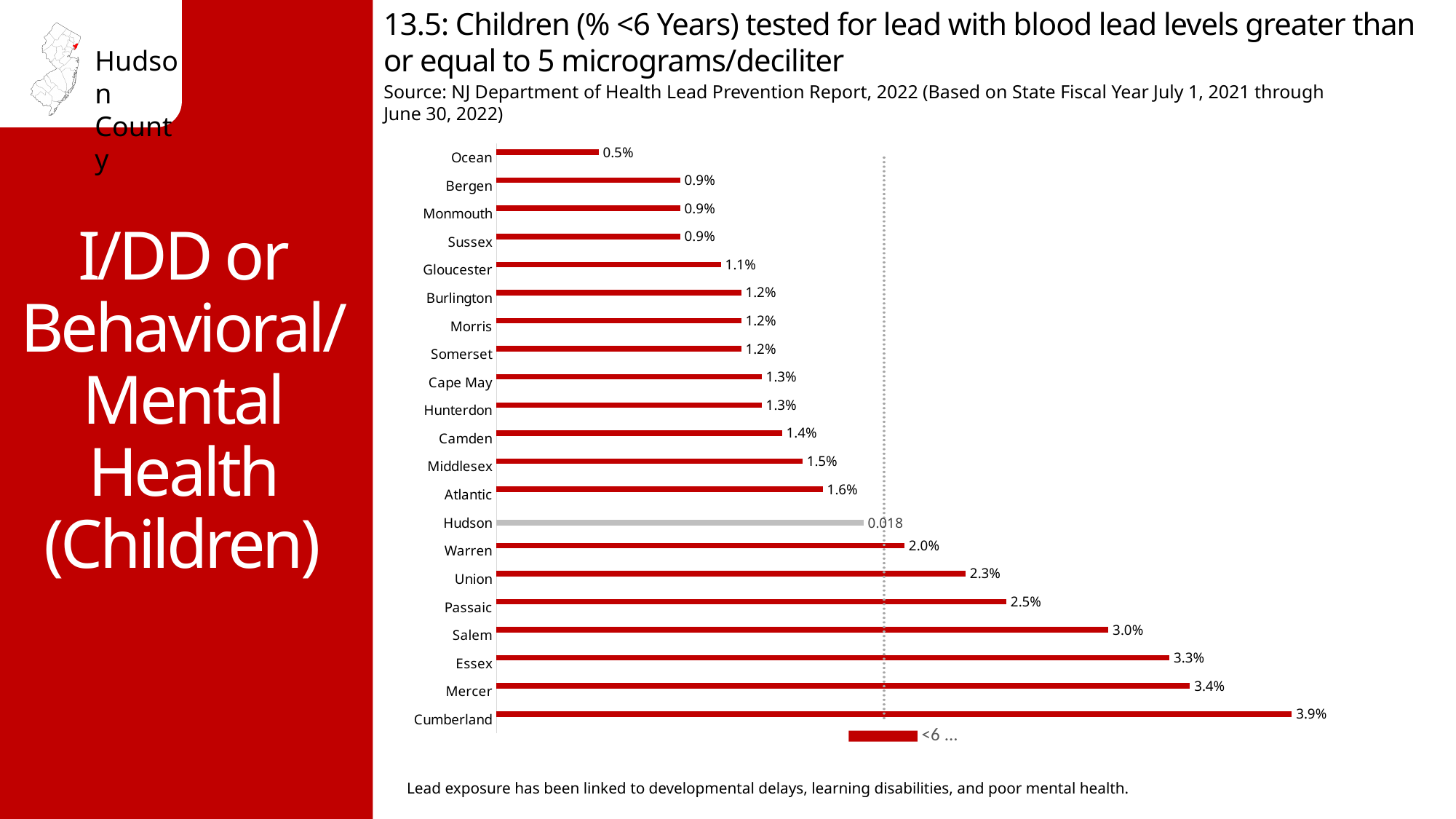
What value is printed next to the Hudson bar? 0.018 What is the value for Passaic? 2.5% Which is larger, the value for Union or the value for Atlantic? Union What is the difference between the values for Mercer and Essex? 0.1% How many counties are shown in the chart? 21 What is the difference between the values for Salem and Warren? 1.0% Which county has the highest value? Cumberland Which county has the lowest value? Ocean Which county's bar is shown in gray instead of red? Hudson What kind of chart is shown on the slide? Bar chart What is the value for Cumberland? 3.9% What is the value for Ocean? 0.5%